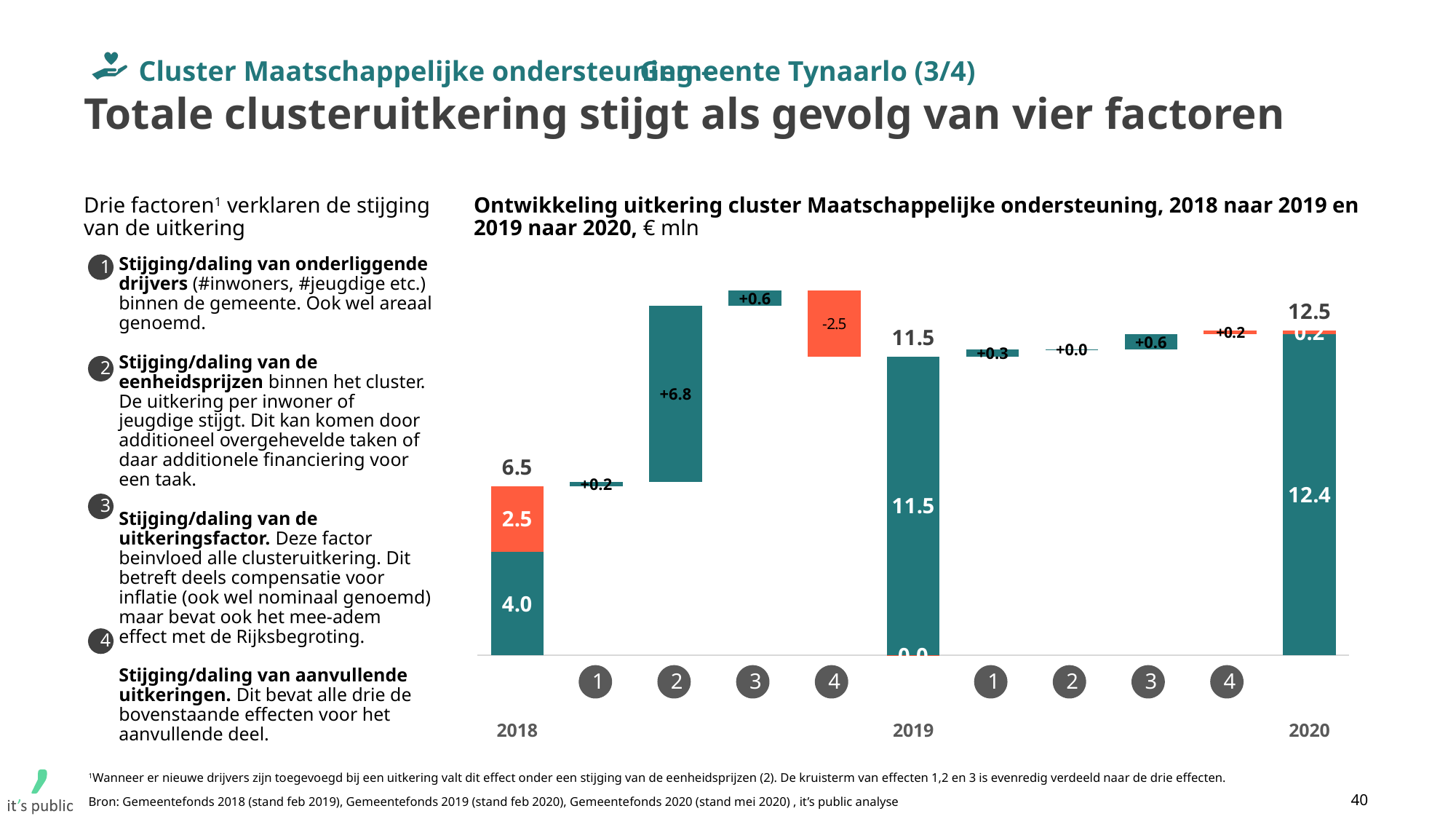
Do the year totals rise or fall from 2018 to 2020? rise What unit is stated in the chart title? € mln What is the total value shown for 2018? 6.5 What is the value of factor 3 in the step from 2019 to 2020? +0.6 Which factor has the largest effect in the step from 2018 to 2019? 2 What is the value of factor 2 in the step from 2018 to 2019? +6.8 What is the value of factor 4 in the step from 2018 to 2019? -2.5 What is the total value shown for 2019? 11.5 Which is larger, the 2019 total or the 2018 total? 2019 What is the value of the teal (lower) segment of the 2018 bar? 4.0 What is the total value shown for 2020? 12.5 What is the difference between the 2020 total and the 2018 total? 6.0